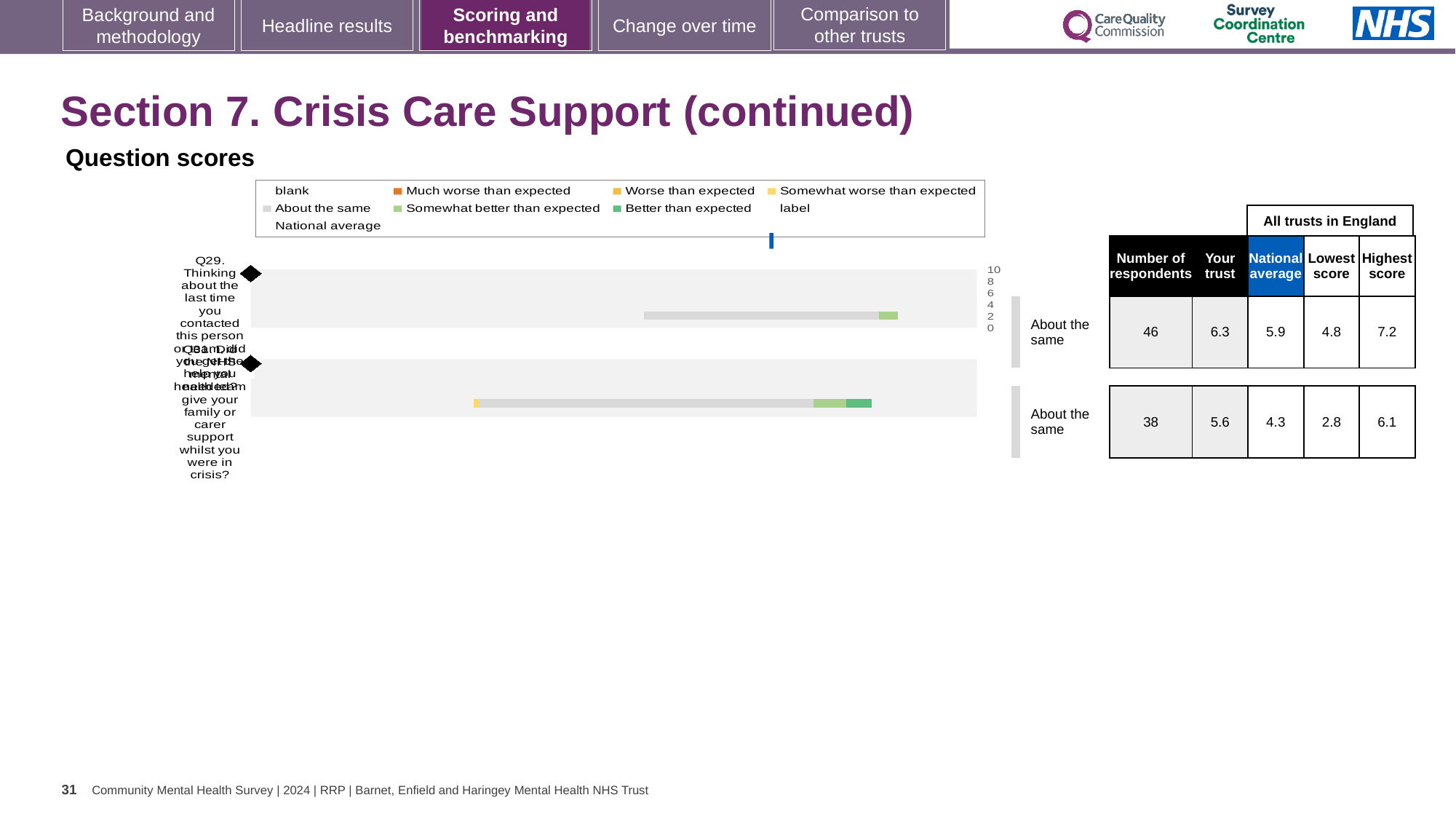
Which question has the higher 'Your trust' score, Q29 or Q31? Q29 What is the national average score for Q29? 5.9 How many questions are plotted in the question scores chart? 2 How many respondents answered Q31? 38 What is the highest score among all trusts in England for Q29? 7.2 What is the 'Your trust' score for Q29 in the question scores table? 6.3 What is the difference between the trust's score and the national average for Q31? 1.3 What benchmark category is shown for both Q29 and Q31? About the same What is the highest value shown on the score axis of the chart? 10 What is the national average score for Q31? 4.3 What is the 'Your trust' score for Q31? 5.6 What kind of chart is used to show the question scores on this slide? bar chart